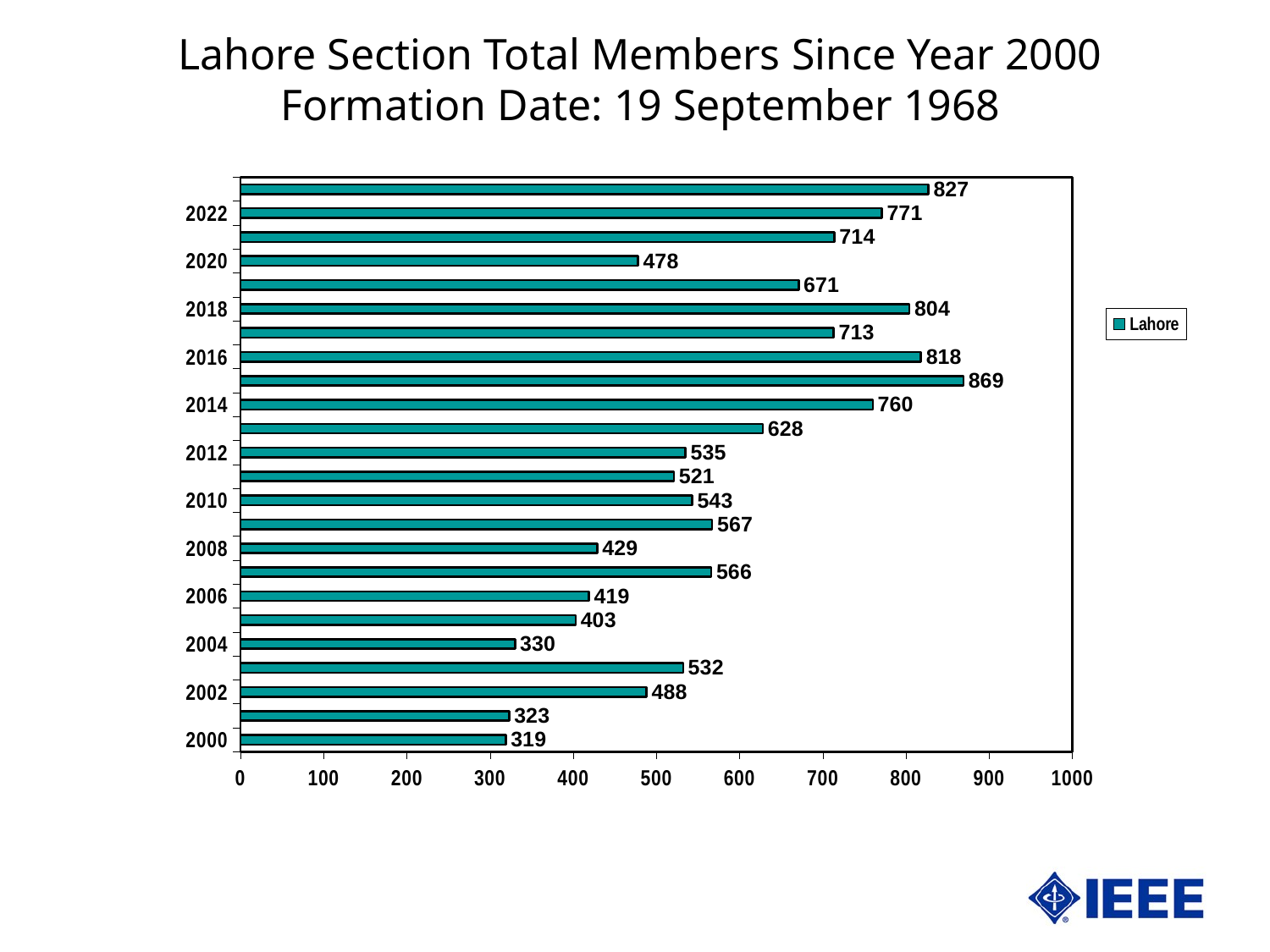
Is the value for 2004 greater or less than 400? less What is the value for 2020? 478 What is the value for 2014? 760 Which labelled year has the lowest value? 2000 What is the highest value shown on the chart? 869 How many series does the legend list? 1 What is the difference between the values for 2022 and 2020? 293 What is the value for 2000? 319 Which is larger, the value for 2016 or the value for 2018? 2016 How many bars are plotted on the chart? 24 What is the value for 2022? 771 What kind of chart is shown? bar chart